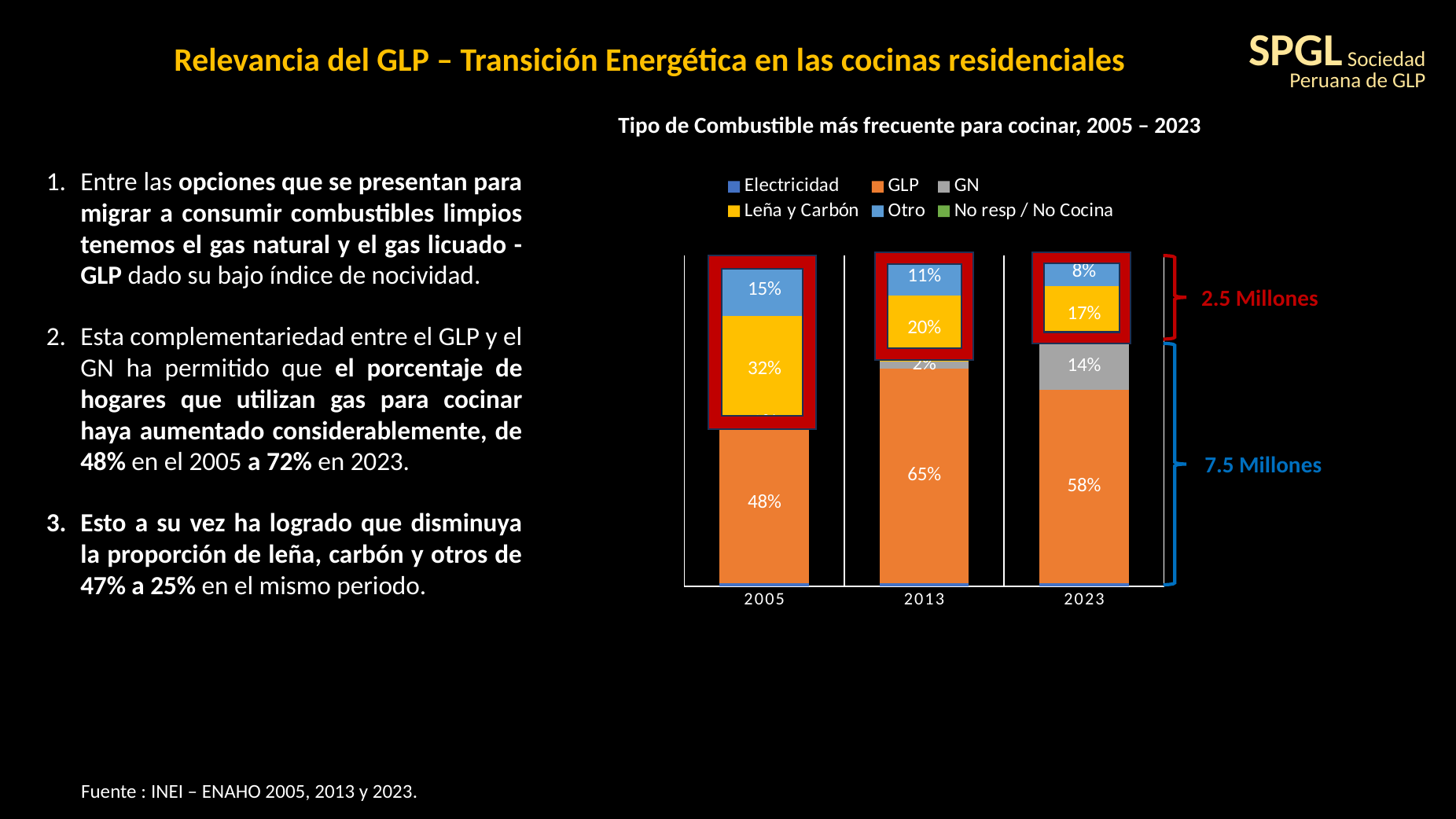
What is the GLP share in 2013? 65% What is the difference between the Otro share in 2005 and in 2023? 7% How many years (categories) are shown on the x axis of the chart? 3 What type of chart is shown on the slide? Stacked bar chart How many series does the chart legend list? 6 What is the Leña y Carbón share in 2023? 17% In which year is the GLP share highest? 2013 What is the GLP share in 2005? 48% What is the GN share in 2023? 14% What is the title of the chart? Tipo de Combustible más frecuente para cocinar, 2005 – 2023 Which is larger, the Leña y Carbón share in 2005 or in 2013? 2005 In which year is the Leña y Carbón share lowest? 2023